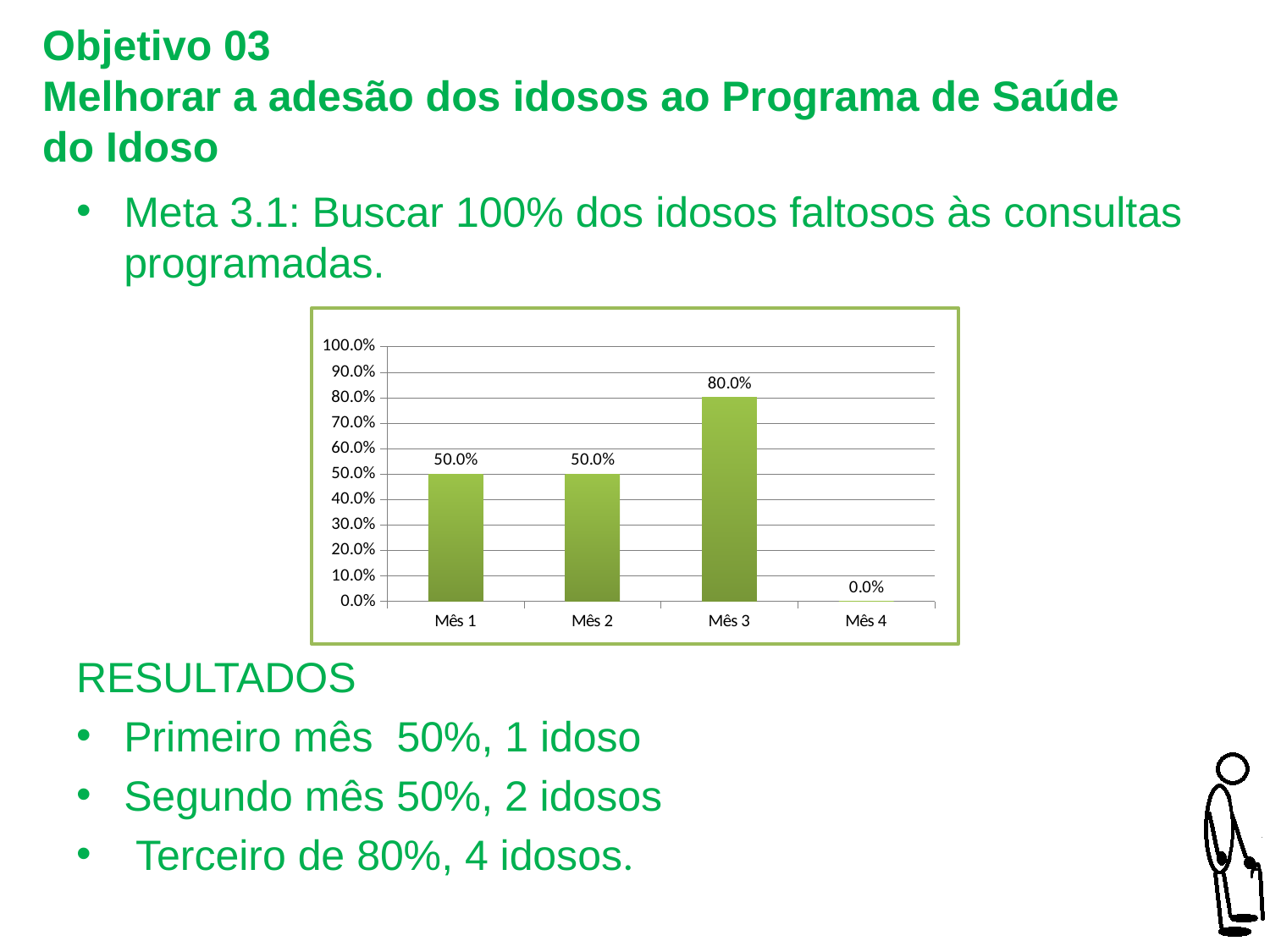
What kind of chart is shown on the slide? bar chart What is the highest tick value shown on the y axis? 100.0% What is the value for Mês 4? 0.0% Which is larger, the value for Mês 3 or the value for Mês 1? Mês 3 What is the difference between the values for Mês 3 and Mês 2? 30.0% What is the value for Mês 1? 50.0% Which month has the highest value? Mês 3 What is the value for Mês 2? 50.0% Is the value for Mês 3 greater or less than 70.0%? greater Which month has the lowest value? Mês 4 How many months are shown on the x axis? 4 What is the value for Mês 3? 80.0%